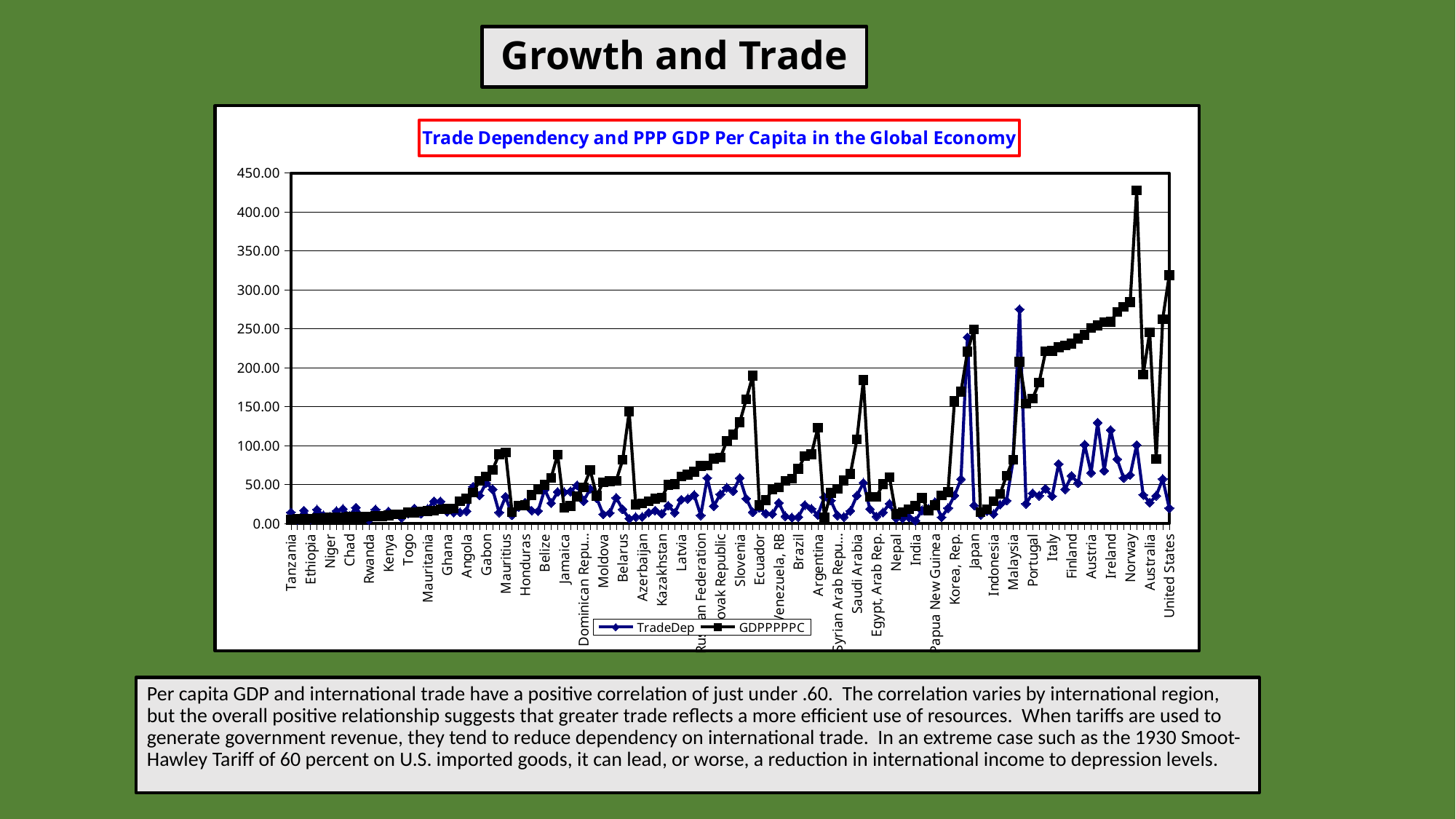
Does the GDPPPPPC series generally rise or fall from left to right along the x axis? rise For United States, which series has the larger value, TradeDep or GDPPPPPC? GDPPPPPC Is the GDPPPPPC value for Tanzania greater or less than 50? less Is the GDPPPPPC value for United States greater or less than 300? greater How many series does the legend list? 2 What kind of chart is shown on the slide? line chart What are the two series named in the legend? TradeDep and GDPPPPPC What is the title of the chart? Trade Dependency and PPP GDP Per Capita in the Global Economy Is the TradeDep value for Tanzania greater or less than 50? less